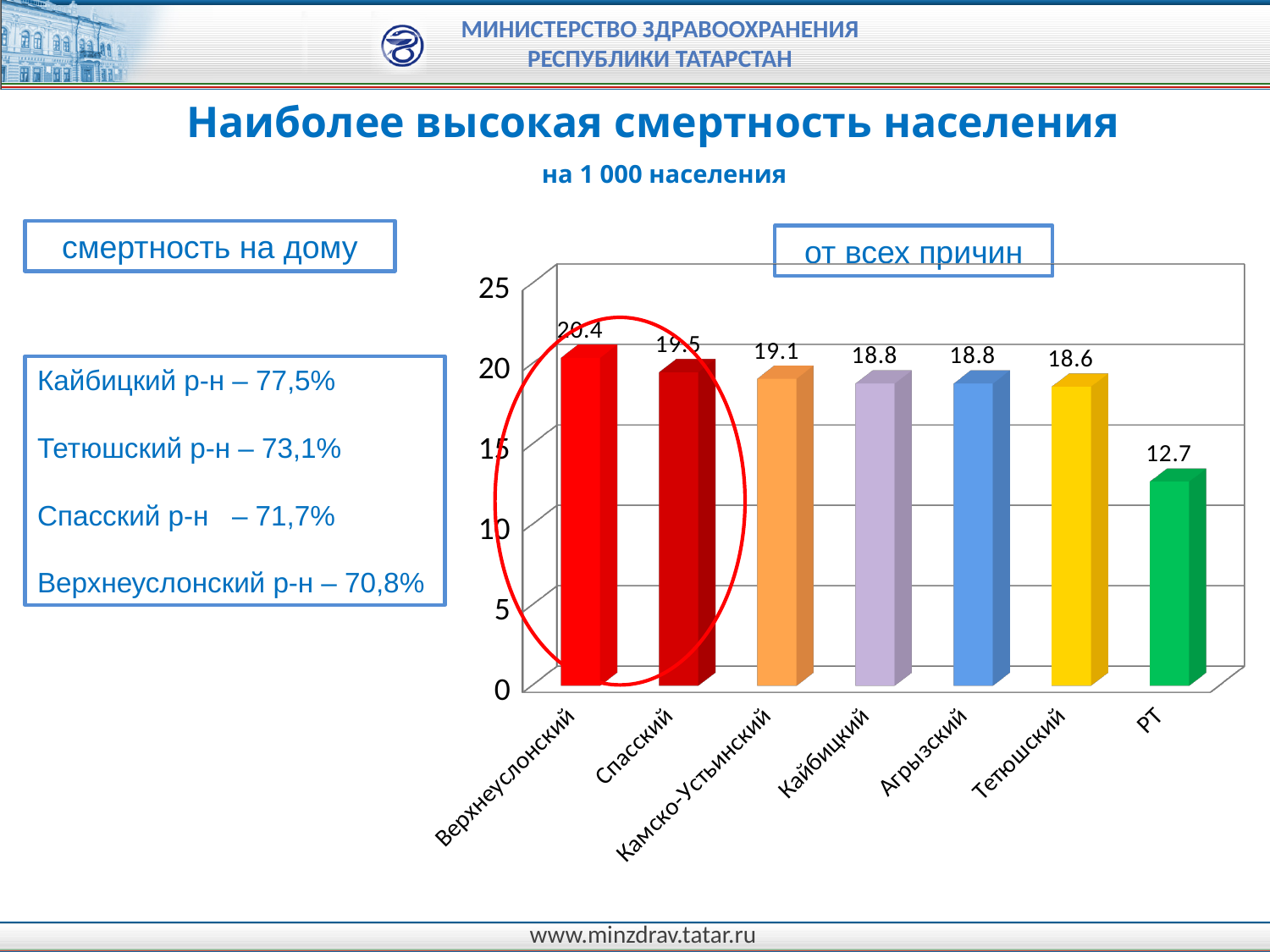
Which is larger, the value for Спасский or the value for Тетюшский? Спасский What kind of chart is shown on the slide? Bar chart What is the value for Верхнеуслонский? 20.4 Which category has the lowest value? РТ Which two categories share the same value of 18.8? Кайбицкий and Агрызский What is the value for РТ? 12.7 Which category has the highest value? Верхнеуслонский What is the value for Камско-Устьинский? 19.1 How many bars are shown in the chart? 7 What is the value for Тетюшский? 18.6 What is the value for Спасский? 19.5 What is the difference between the values for Верхнеуслонский and РТ? 7.7